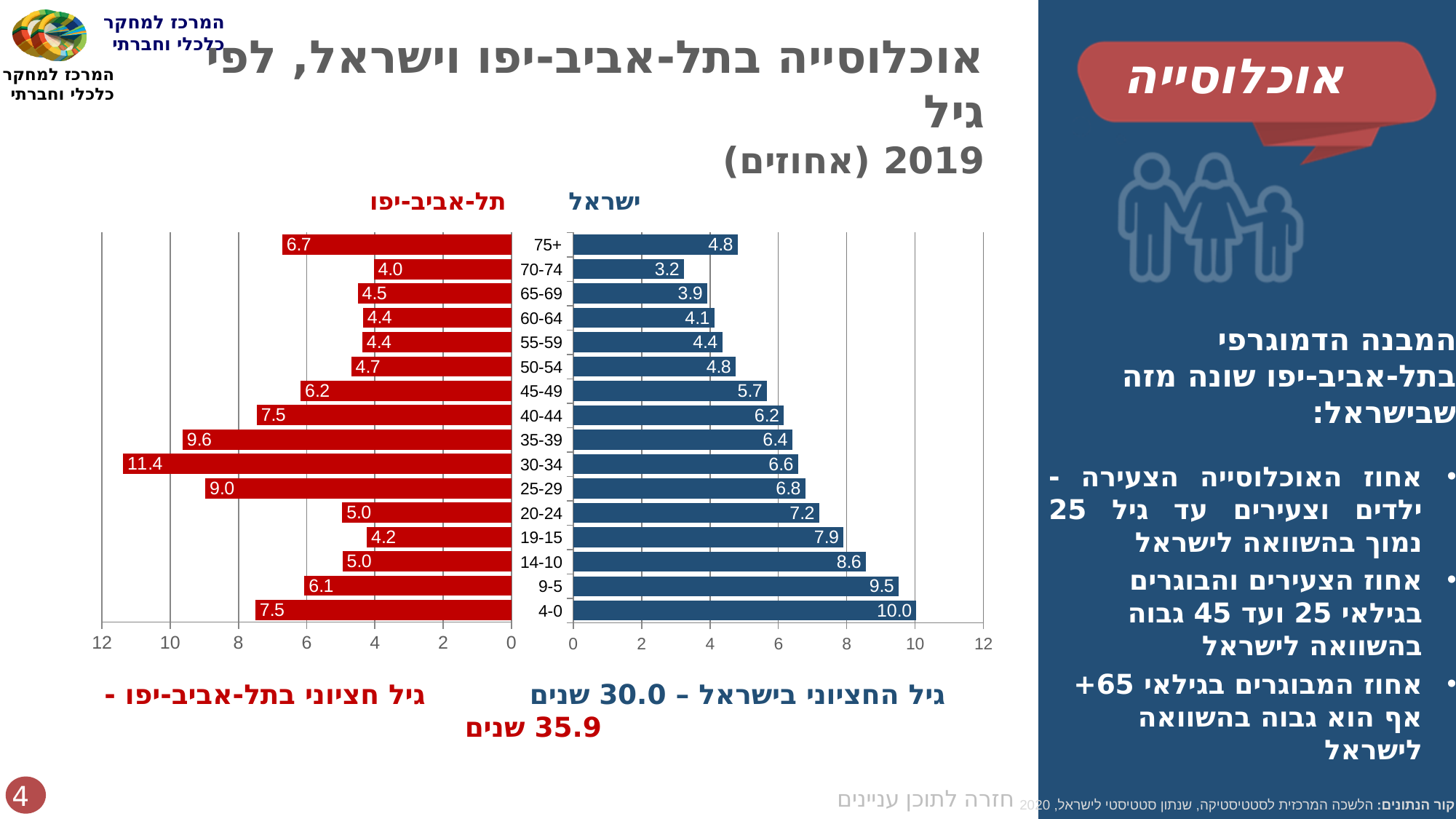
What is the value for the 75+ age group in the Israel (ישראל) series? 4.8 What is the difference between the Tel Aviv-Yafo and Israel values for the 30-34 age group? 4.8 What kind of chart is shown on the slide? Bar chart What is the value for the 4-0 age group in the Israel (ישראל) series? 10.0 Which age group has the highest value in the Tel Aviv-Yafo (תל-אביב-יפו) series? 30-34 Which age group has the lowest value in the Tel Aviv-Yafo (תל-אביב-יפו) series? 70-74 Which age group has the lowest value in the Israel (ישראל) series? 70-74 For the 4-0 age group, which series has the larger value, Tel Aviv-Yafo or Israel? Israel (ישראל) How many series does the chart show? 2 Which colour represents the Israel (ישראל) series? Blue What is the value for the 30-34 age group in the Tel Aviv-Yafo (תל-אביב-יפו) series? 11.4 How many age groups are shown on the chart? 16